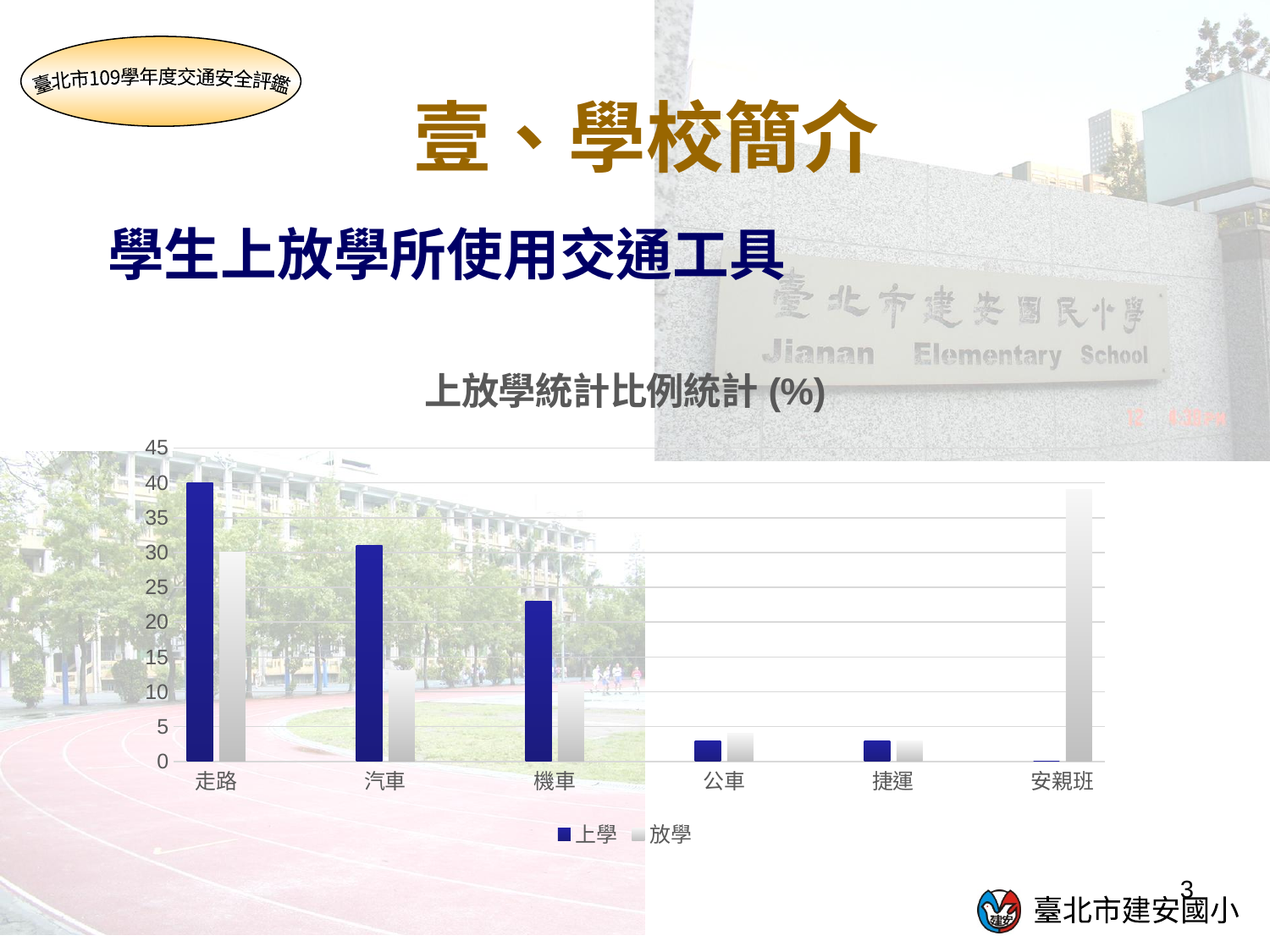
Which category has the lowest value for the 上學 series? 安親班 How many series does the chart legend list? 2 Is the 放學 value for 安親班 greater or less than 35? greater Which series is shown in blue in the chart? 上學 Is the 放學 value for 汽車 greater or less than 20? less For 機車, which series has the larger value, 上學 or 放學? 上學 Which category has the highest value for the 上學 series? 走路 What is the title of the chart? 上放學統計比例統計 (%) How many categories are shown on the x axis of the chart? 6 Is the 上學 value for 走路 greater or less than 35? greater Which category has the highest value for the 放學 series? 安親班 What type of chart is shown on the slide? bar chart